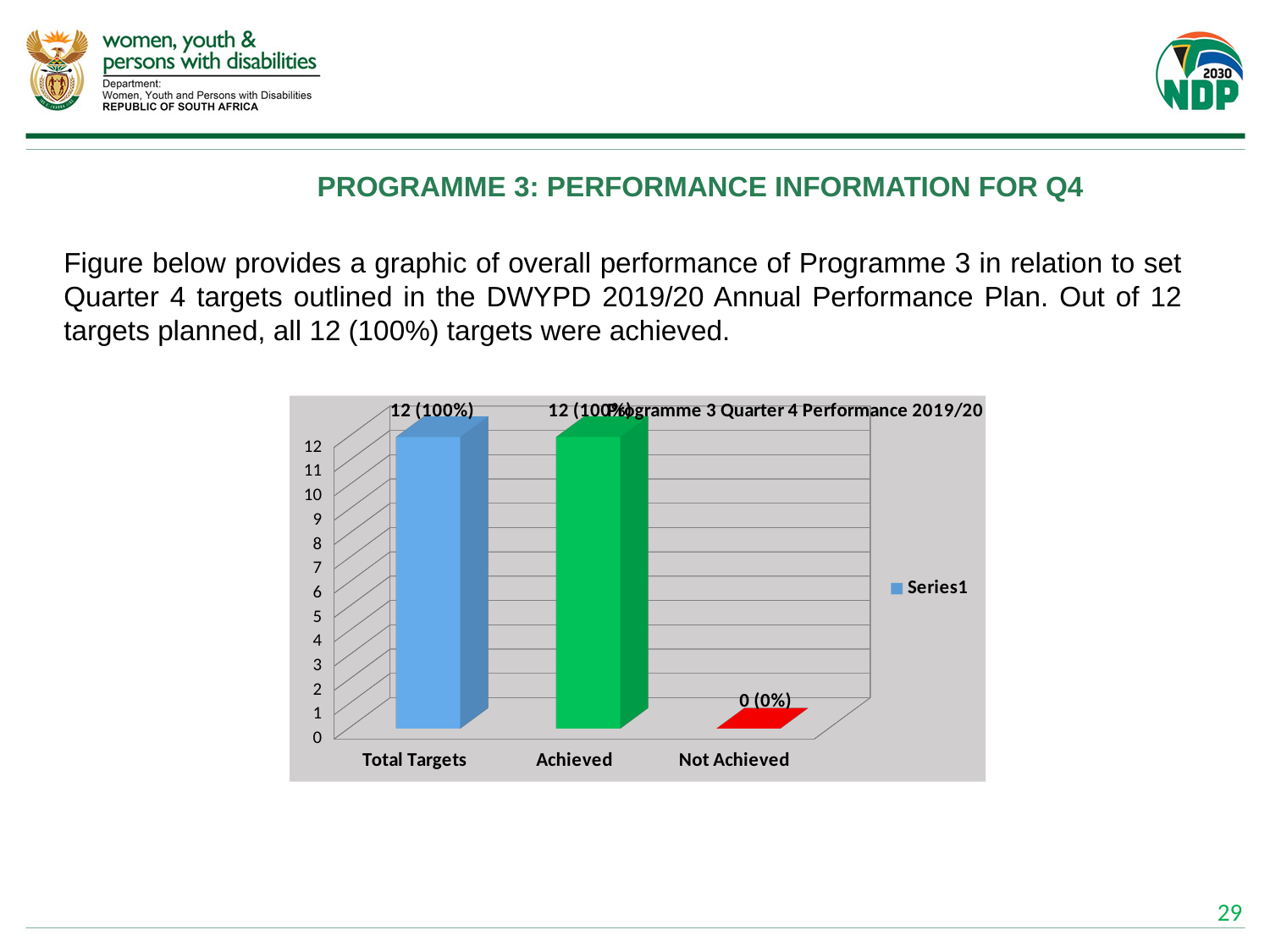
Which is larger, the value for Achieved or the value for Not Achieved? Achieved What is the value shown for Total Targets? 12 (100%) Is the value for Achieved greater or less than 6? greater What is the difference between the Achieved value and the Not Achieved value? 12 What is the title of the chart? Programme 3 Quarter 4 Performance 2019/20 What kind of chart is shown on the slide? Bar chart What is the value shown for Not Achieved? 0 (0%) What colour is the bar for Achieved? Green How many categories are shown on the x axis? 3 What is the value shown for Achieved? 12 (100%) Which category has the lowest value? Not Achieved How many series does the legend list? 1